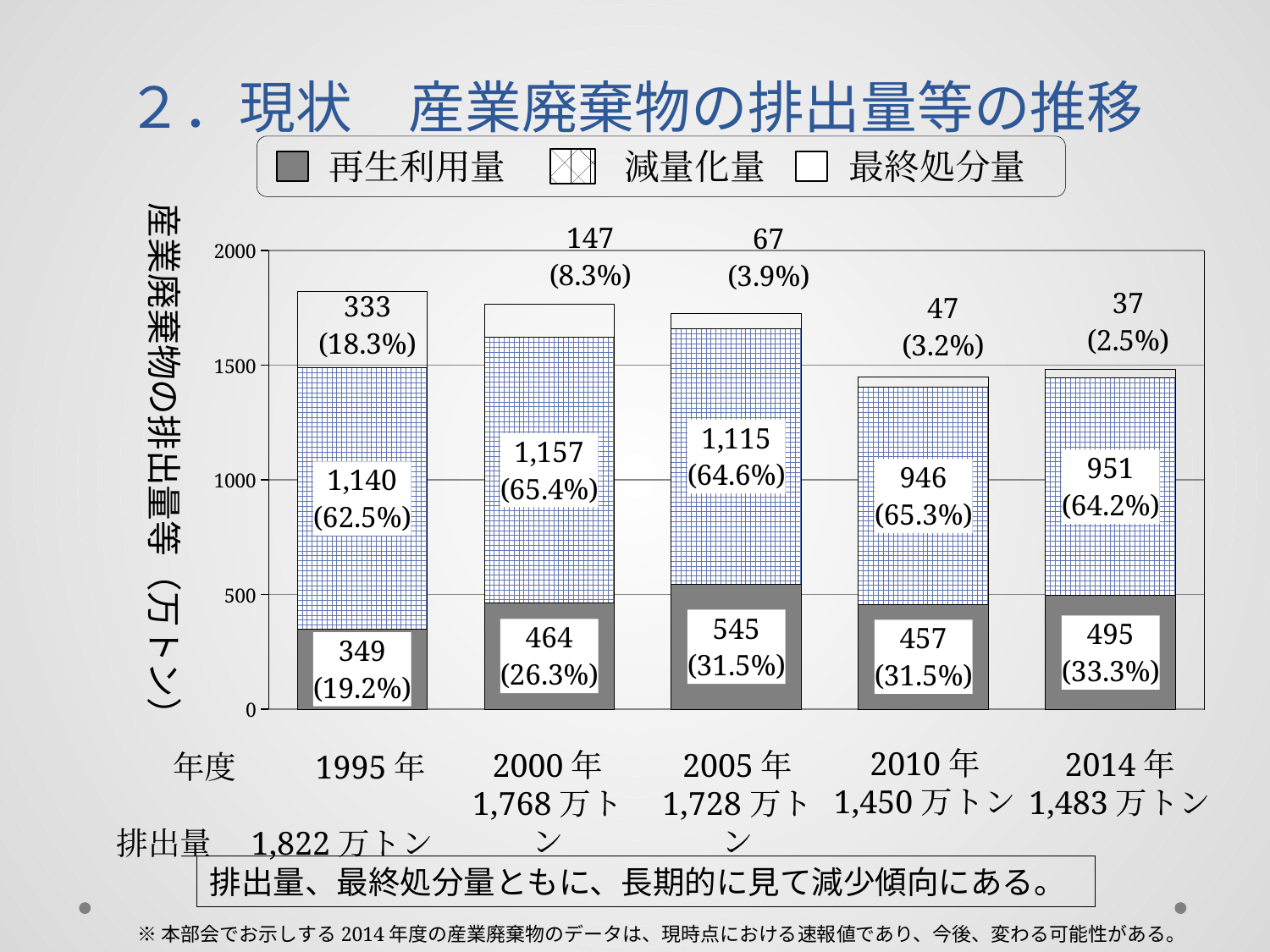
What is the 最終処分量 value for 1995年? 333 What is the 再生利用量 value for 2005年? 545 Which is larger, the 減量化量 in 1995年 or in 2010年? 1995年 How many years (categories) are plotted on the x axis? 5 What percentage is shown for 減量化量 in 2000年? 65.4% Which year has the highest 再生利用量? 2005年 Which year has the lowest 最終処分量? 2014年 What kind of chart is shown on the slide? Stacked bar chart Does the 最終処分量 rise or fall from 1995年 to 2014年? Fall What is the total 排出量 shown for 2010年? 1,450万トン How many series does the legend list? 3 What is the difference between the 最終処分量 in 1995年 and in 2014年? 296